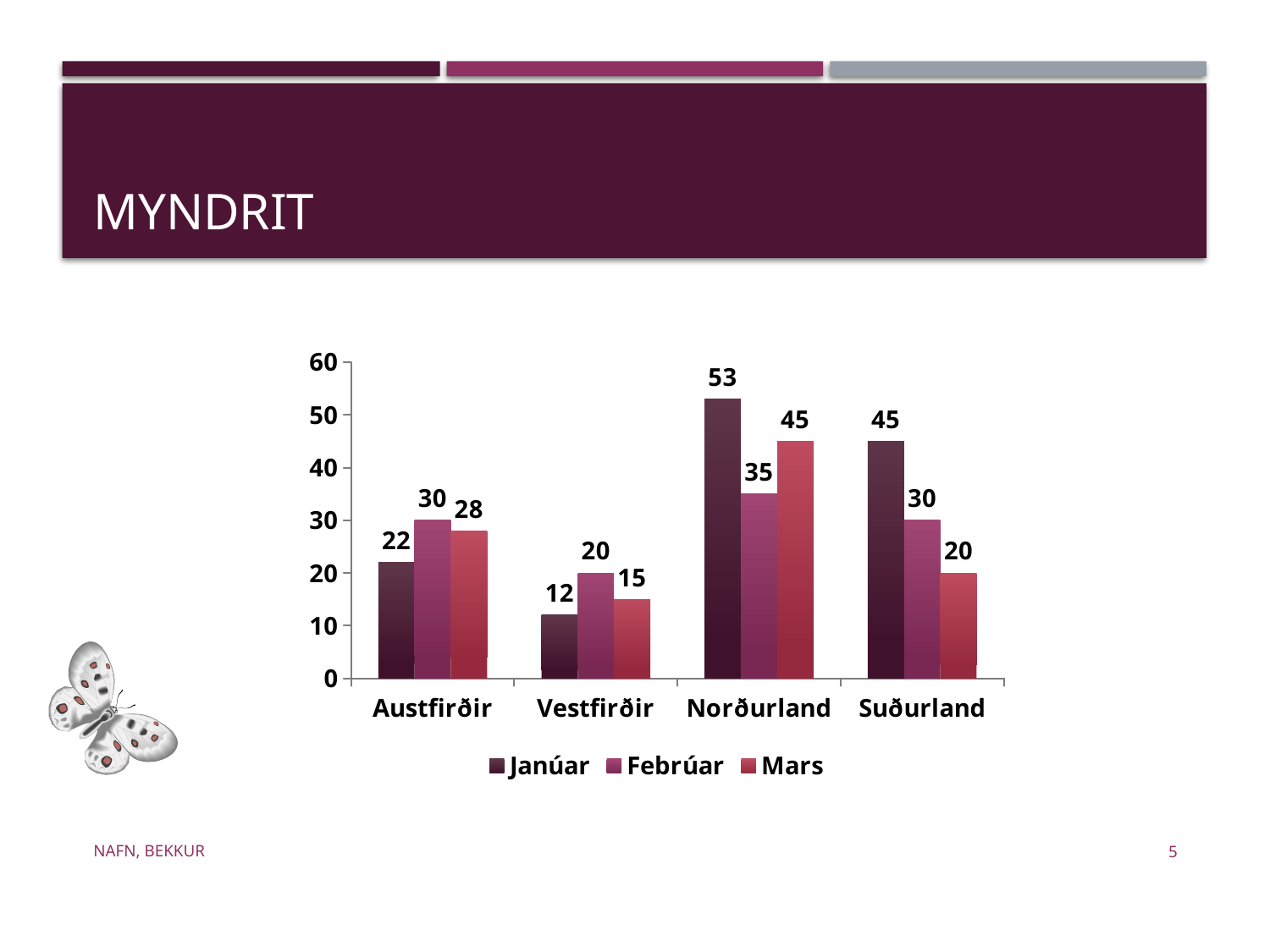
How many series does the legend list? 3 What are the series names listed in the legend? Janúar, Febrúar, Mars What is the value for Mars in Austfirðir? 28 What kind of chart is shown on the slide? bar chart Which category has the highest Janúar value? Norðurland How many categories are shown on the x axis? 4 Which category has the lowest Mars value? Vestfirðir What is the value for Janúar in Norðurland? 53 Is the Janúar value for Austfirðir greater or less than 30? less What is the value for Febrúar in Vestfirðir? 20 Which is larger: the Febrúar value for Norðurland or the Febrúar value for Suðurland? Norðurland What is the difference between the Janúar and Mars values for Suðurland? 25